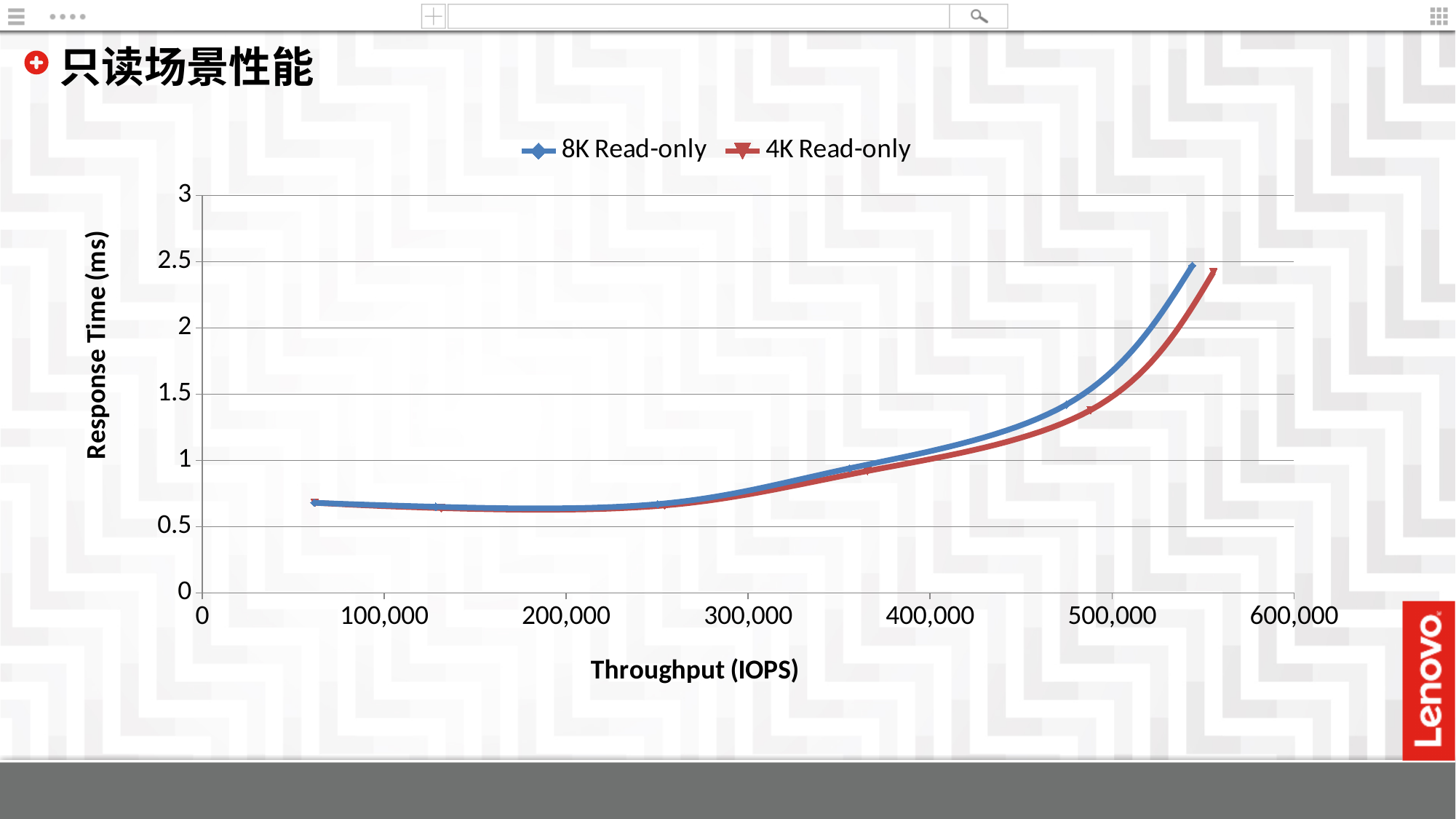
What are the two series named in the legend? 8K Read-only and 4K Read-only Does the response time for 8K Read-only rise or fall as throughput increases beyond 300,000 IOPS? rise Is the response time for 4K Read-only at its highest throughput point greater or less than 2? greater Is the response time for 8K Read-only at its highest throughput point greater or less than 2? greater How many series does the legend list? 2 Is the response time for 8K Read-only at around 100,000 IOPS greater or less than 1? less What is the title of the vertical axis? Response Time (ms) What is the maximum value shown on the Response Time (ms) axis? 3 What kind of chart is shown on the slide? line chart